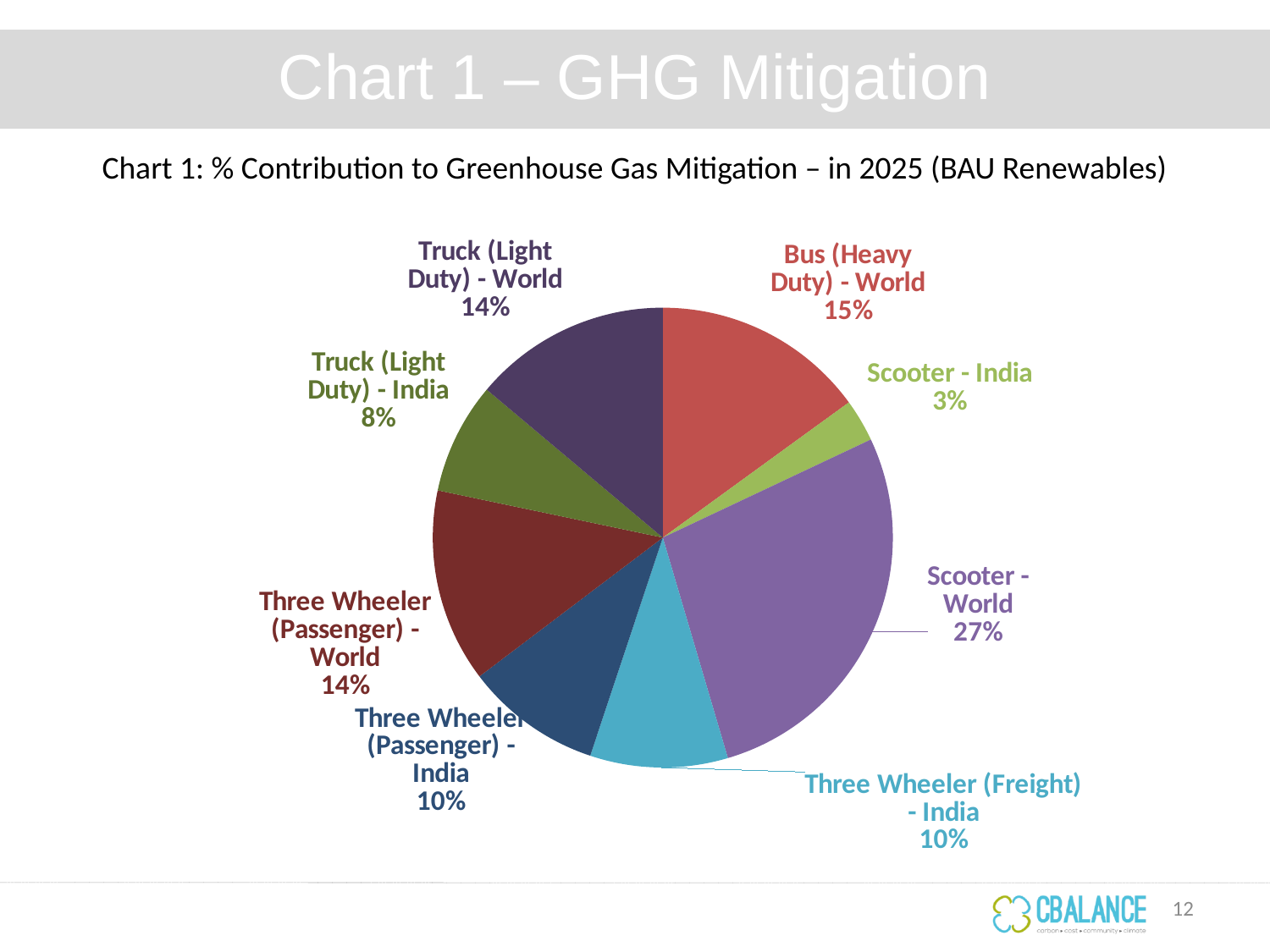
Which category has the smallest slice of the pie? Scooter - India Which category has the largest slice of the pie? Scooter - World What is the value shown for Bus (Heavy Duty) - World? 15% How many categories are shown in the pie chart? 8 What is the value shown for Three Wheeler (Freight) - India? 10% What is the value shown for Truck (Light Duty) - India? 8% Which is larger, the share for Bus (Heavy Duty) - World or the share for Three Wheeler (Passenger) - India? Bus (Heavy Duty) - World What share of greenhouse gas mitigation does Scooter - World contribute? 27% What is the title of the chart? Chart 1: % Contribution to Greenhouse Gas Mitigation – in 2025 (BAU Renewables) What kind of chart is shown on the slide? pie chart What is the difference between the shares of Scooter - World and Bus (Heavy Duty) - World? 12% What is the difference between the shares of Truck (Light Duty) - World and Truck (Light Duty) - India? 6%